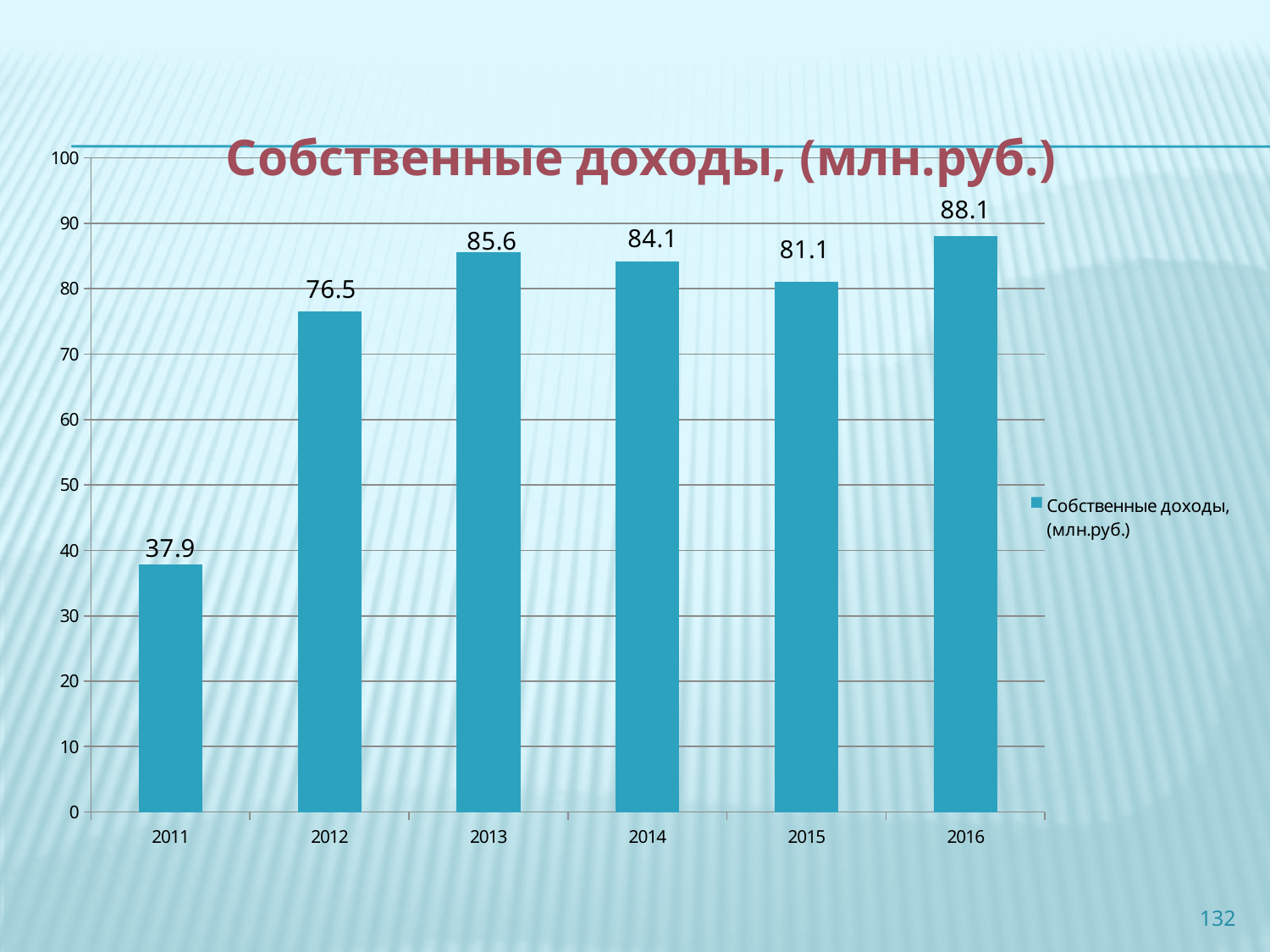
What kind of chart is this? bar chart Is the value for 2012 greater or less than 70? greater Which is larger, the value for 2012 or the value for 2015? 2015 Which year has the lowest value? 2011 What is the value for 2014? 84.1 What is the value for 2016? 88.1 What is the title of the chart? Собственные доходы, (млн.руб.) What is the difference between the values for 2016 and 2011? 50.2 Which year has the highest value? 2016 What is the value for 2011? 37.9 How many years are shown on the x axis? 6 What is the difference between the values for 2013 and 2015? 4.5